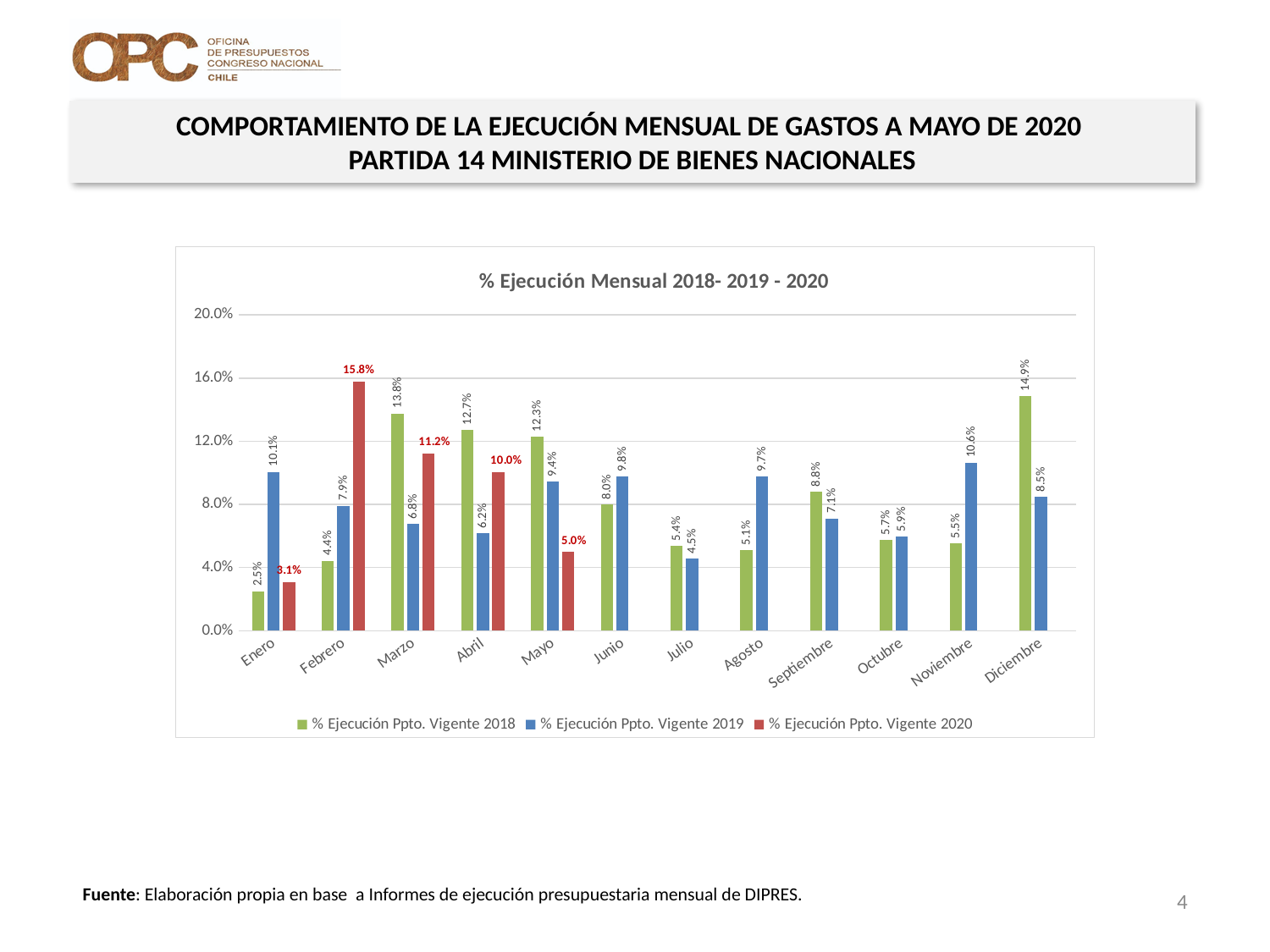
What is the difference between the 2020 and 2018 values in Mayo? 7.3% Which month has the lowest value for % Ejecución Ppto. Vigente 2020? Enero How many months are shown on the x axis? 12 How many series does the legend list? 3 Which month has the lowest value for % Ejecución Ppto. Vigente 2019? Julio What is the value for % Ejecución Ppto. Vigente 2019 in Noviembre? 10.6% What kind of chart is shown on the slide? Bar chart What is the title of the chart? % Ejecución Mensual 2018- 2019 - 2020 What is the value for % Ejecución Ppto. Vigente 2020 in Febrero? 15.8% In Enero, which series has the larger value: % Ejecución Ppto. Vigente 2019 or % Ejecución Ppto. Vigente 2020? % Ejecución Ppto. Vigente 2019 What is the value for % Ejecución Ppto. Vigente 2018 in Diciembre? 14.9% Which month has the highest value for % Ejecución Ppto. Vigente 2018? Diciembre